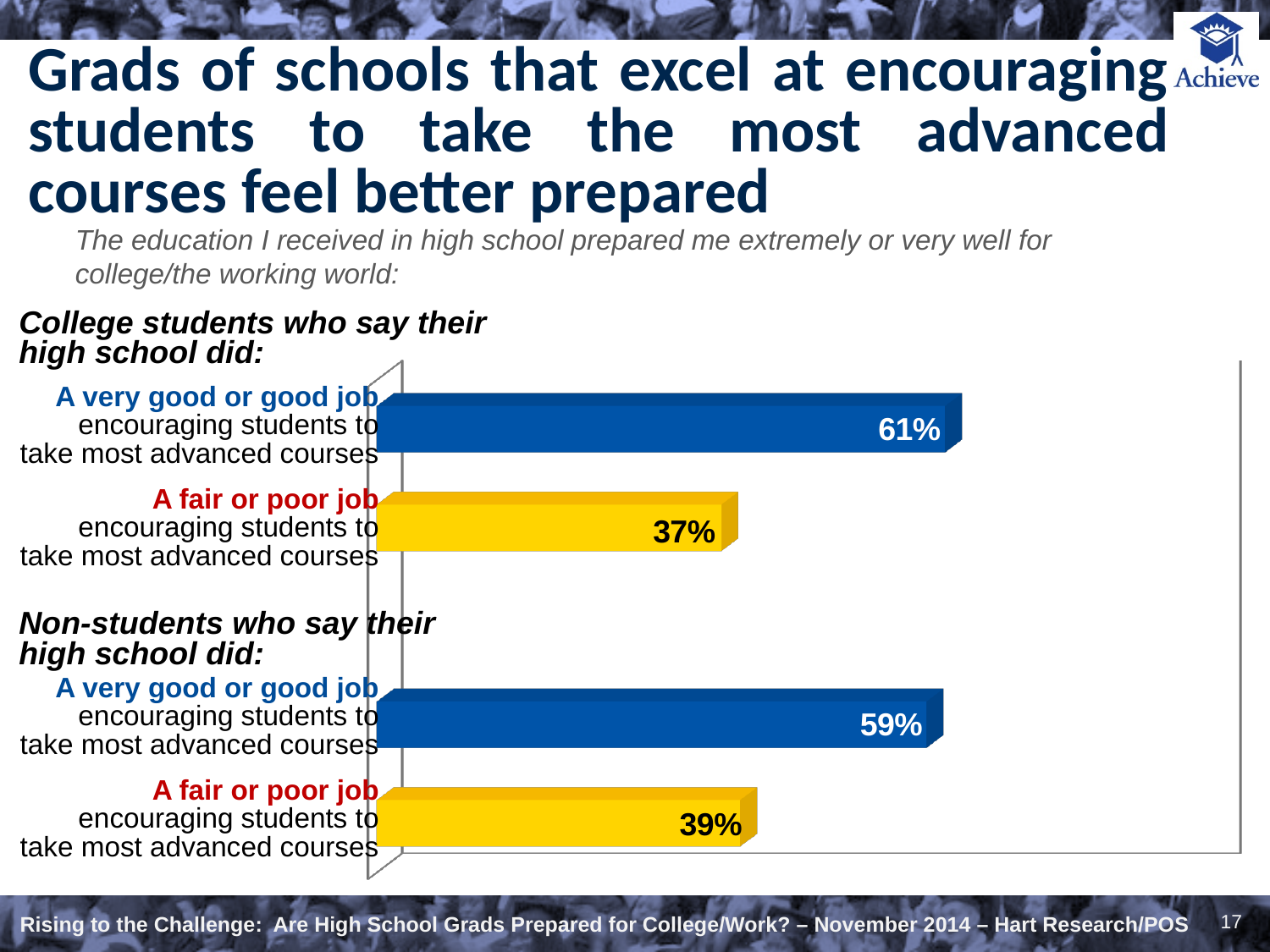
What is the difference between the college students' values for a very good or good job and a fair or poor job? 24 percentage points What percentage of college students whose high school did a fair or poor job encouraging students to take the most advanced courses say their high school prepared them extremely or very well? 37% What is the difference between the non-students' values for a very good or good job and a fair or poor job? 20 percentage points What percentage of college students whose high school did a very good or good job encouraging students to take the most advanced courses say their high school prepared them extremely or very well? 61% Which bar in the chart has the highest value? College students, a very good or good job Which is larger: the value for college students whose high school did a fair or poor job, or the value for non-students whose high school did a fair or poor job? Non-students (39%) How many bars are plotted in the chart? 4 What percentage of non-students whose high school did a very good or good job encouraging students to take the most advanced courses say their high school prepared them extremely or very well? 59% Which bar in the chart has the lowest value? College students, a fair or poor job What type of chart is shown on the slide? Bar chart What colour are the bars for 'A very good or good job' in the chart? Blue What percentage of non-students whose high school did a fair or poor job encouraging students to take the most advanced courses say their high school prepared them extremely or very well? 39%